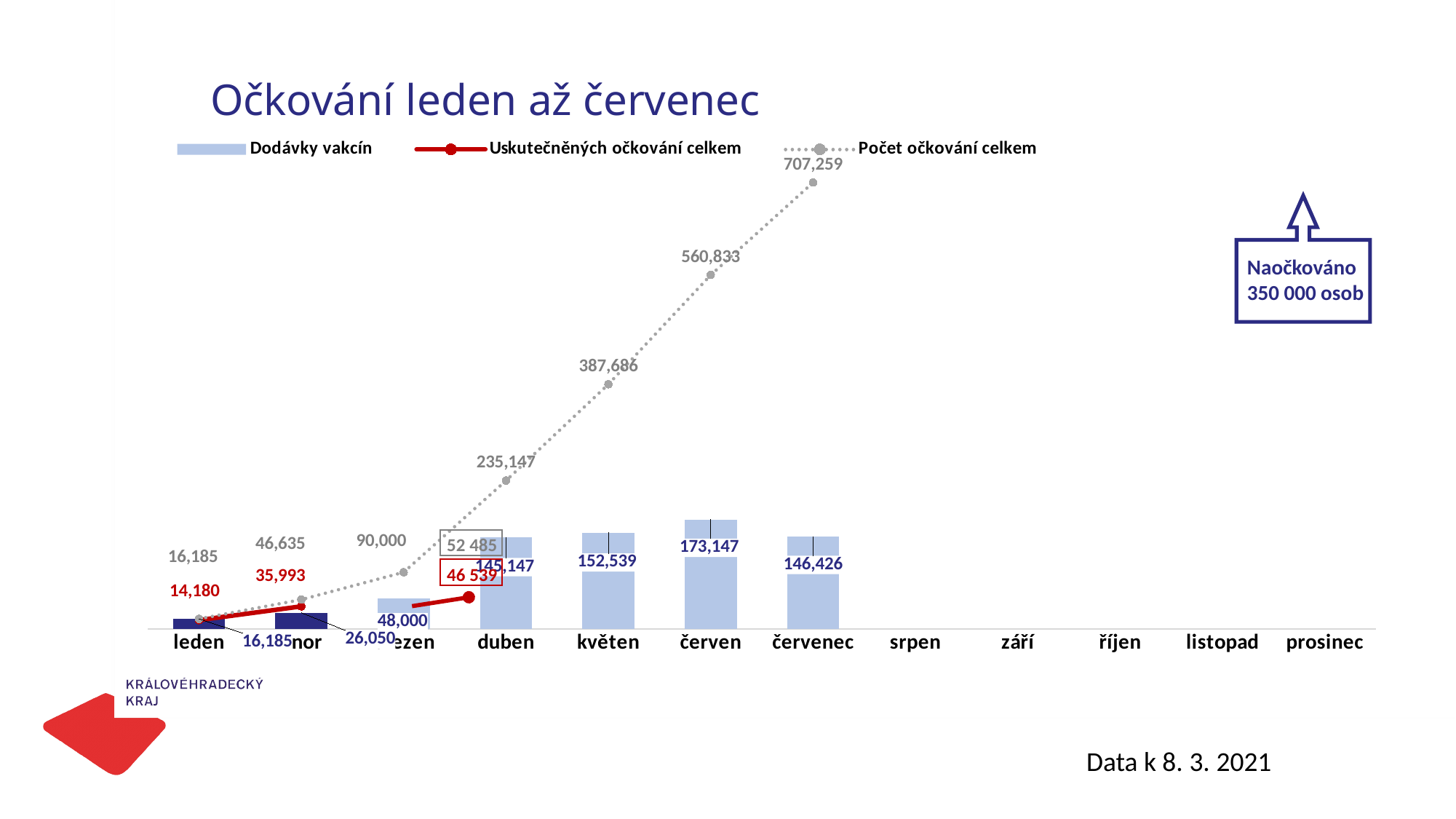
What is the difference between Počet očkování celkem for červenec and červen? 146,426 Does the Počet očkování celkem line rise or fall from leden to červenec? rise Which is larger, Dodávky vakcín for duben or for červenec? červenec How many months are labelled on the x axis? 12 What is the value of Uskutečněných očkování celkem for únor? 35,993 Which month has the lowest Dodávky vakcín bar among the months with bars? leden How many series does the legend list? 3 What is the value of Počet očkování celkem for červenec? 707,259 What is the difference between Dodávky vakcín for červen and květen? 20,608 What is the title of the chart? Očkování leden až červenec What is the value of Dodávky vakcín for červen? 173,147 Which month has the highest Dodávky vakcín bar? červen